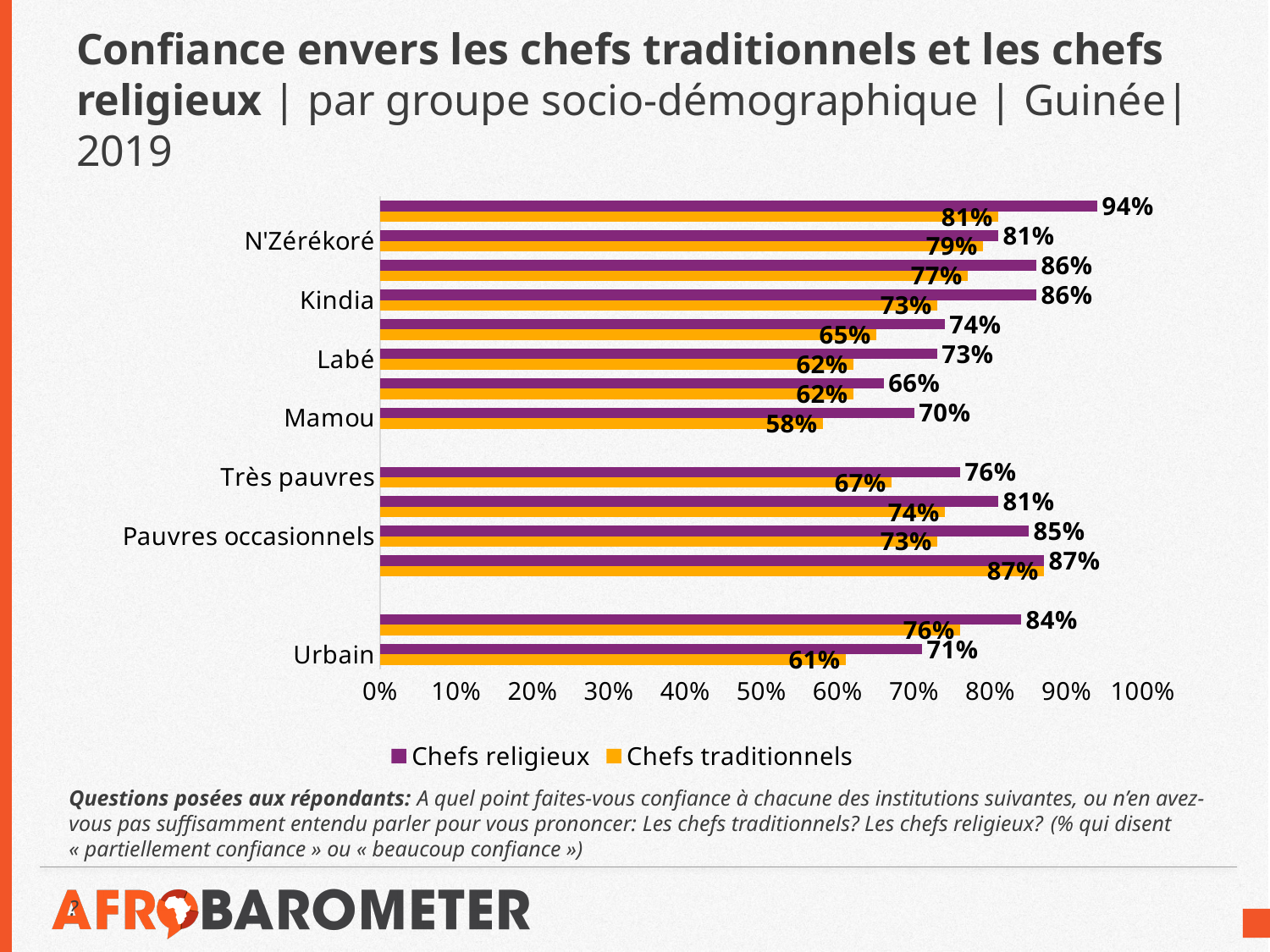
In Kindia, what is the difference between trust in Chefs religieux and trust in Chefs traditionnels? 13 percentage points Which has the higher value for Chefs religieux, Kindia or Urbain? Kindia Among Très pauvres, how much higher is trust in Chefs religieux than in Chefs traditionnels? 9 percentage points What percentage of respondents in Kindia trust the Chefs religieux? 86% How many series does the legend list? 2 What type of chart is shown on the slide? Bar chart What is the value for Chefs traditionnels in Mamou? 58% In Labé, which series has the higher value, Chefs religieux or Chefs traditionnels? Chefs religieux What is the value for Chefs traditionnels among Pauvres occasionnels? 73% What is the value for Chefs traditionnels in N'Zérékoré? 79% Is the value for Chefs religieux among Pauvres occasionnels greater or less than 80%? greater What is the value for Chefs religieux among Urbain respondents? 71%